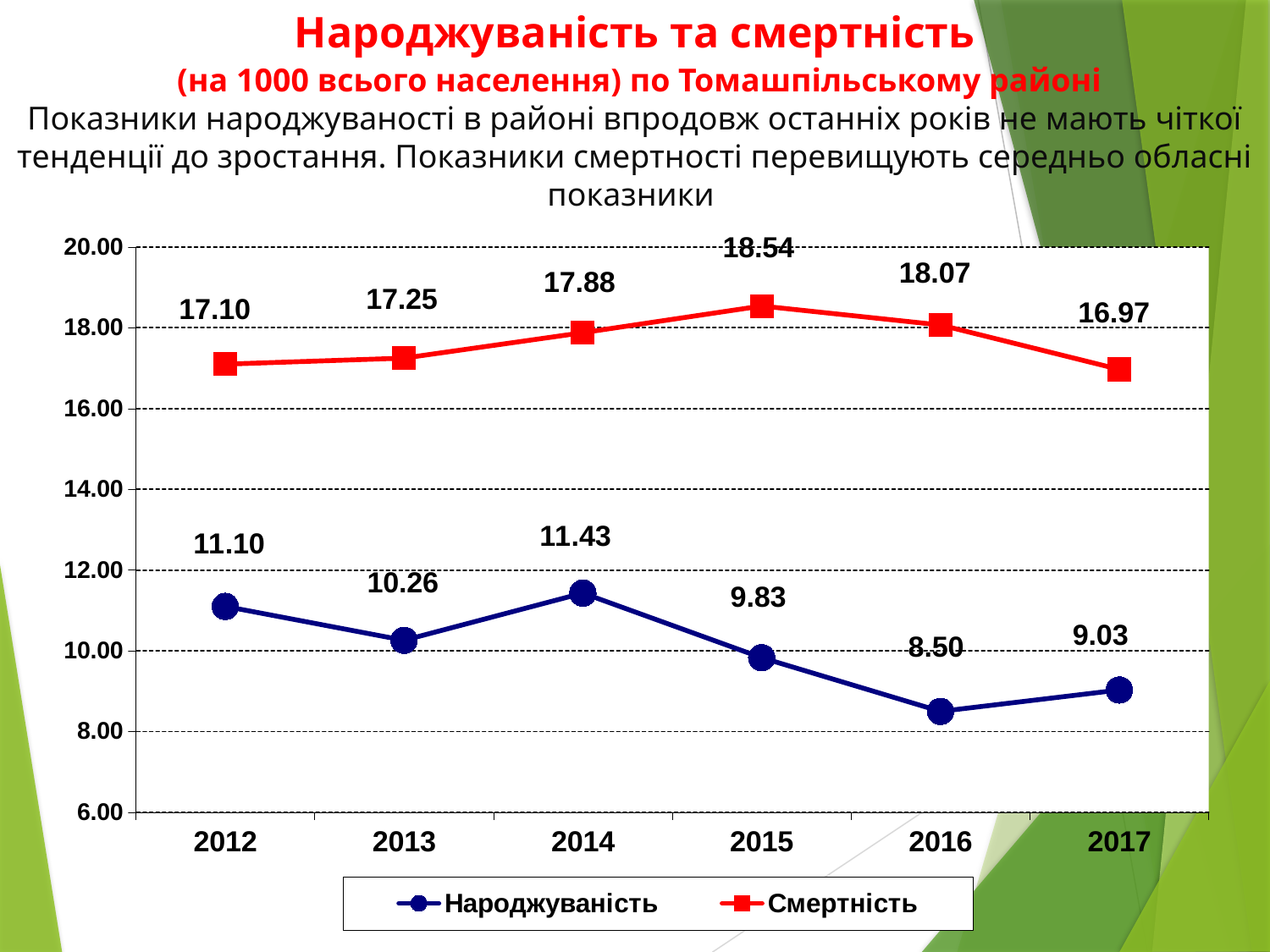
What is the value of Смертність in 2015? 18.54 What is the difference between Смертність and Народжуваність in 2017? 7.94 Is the value of Смертність in 2014 greater or less than 18.00? less What is the value of Народжуваність in 2013? 10.26 Does Смертність rise or fall from 2015 to 2017? fall How many series does the legend list? 2 In which year is Смертність highest? 2015 Which colour is used for the Народжуваність series? blue How many years are shown on the x axis? 6 In which year is Народжуваність lowest? 2016 Which is larger, Народжуваність in 2012 or Народжуваність in 2014? 2014 What kind of chart is shown on the slide? line chart